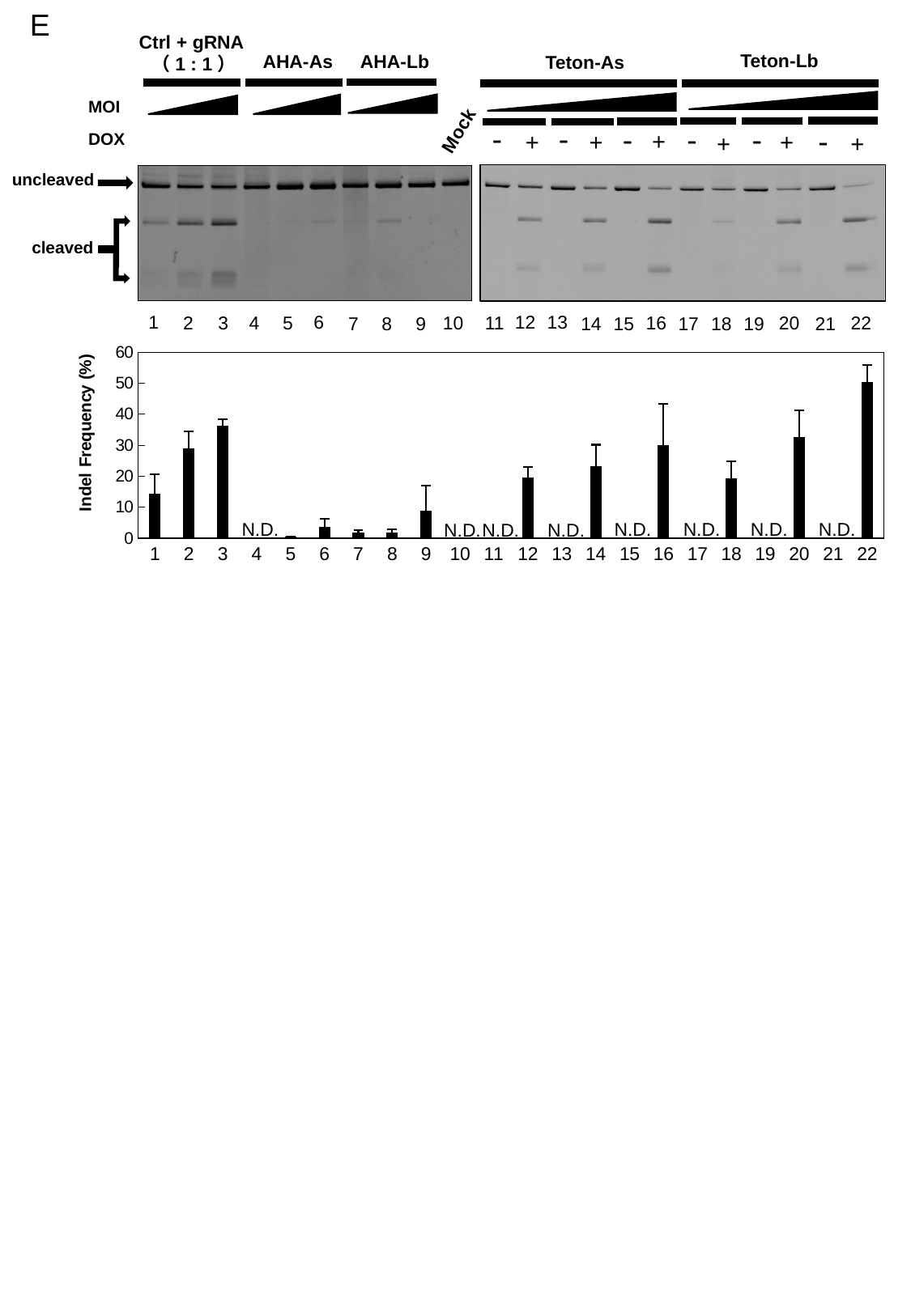
How many lanes are marked N.D. in the bar chart? 8 What kind of chart is shown below the gel image? bar chart Is the indel frequency for lane 12 greater or less than 30? less How many lane categories are labelled along the x axis of the bar chart? 22 What is the label of the y axis of the bar chart? Indel Frequency (%) Which lane has the highest indel frequency in the bar chart? 22 Is the indel frequency for lane 3 greater or less than 30? greater What is shown for lane 21 in the bar chart? N.D. Is the indel frequency for lane 1 greater or less than 20? less Do the indel frequencies rise or fall from lane 1 to lane 3? rise What is shown for lane 4 in the bar chart? N.D. Which lane has the larger indel frequency, lane 18 or lane 20? 20